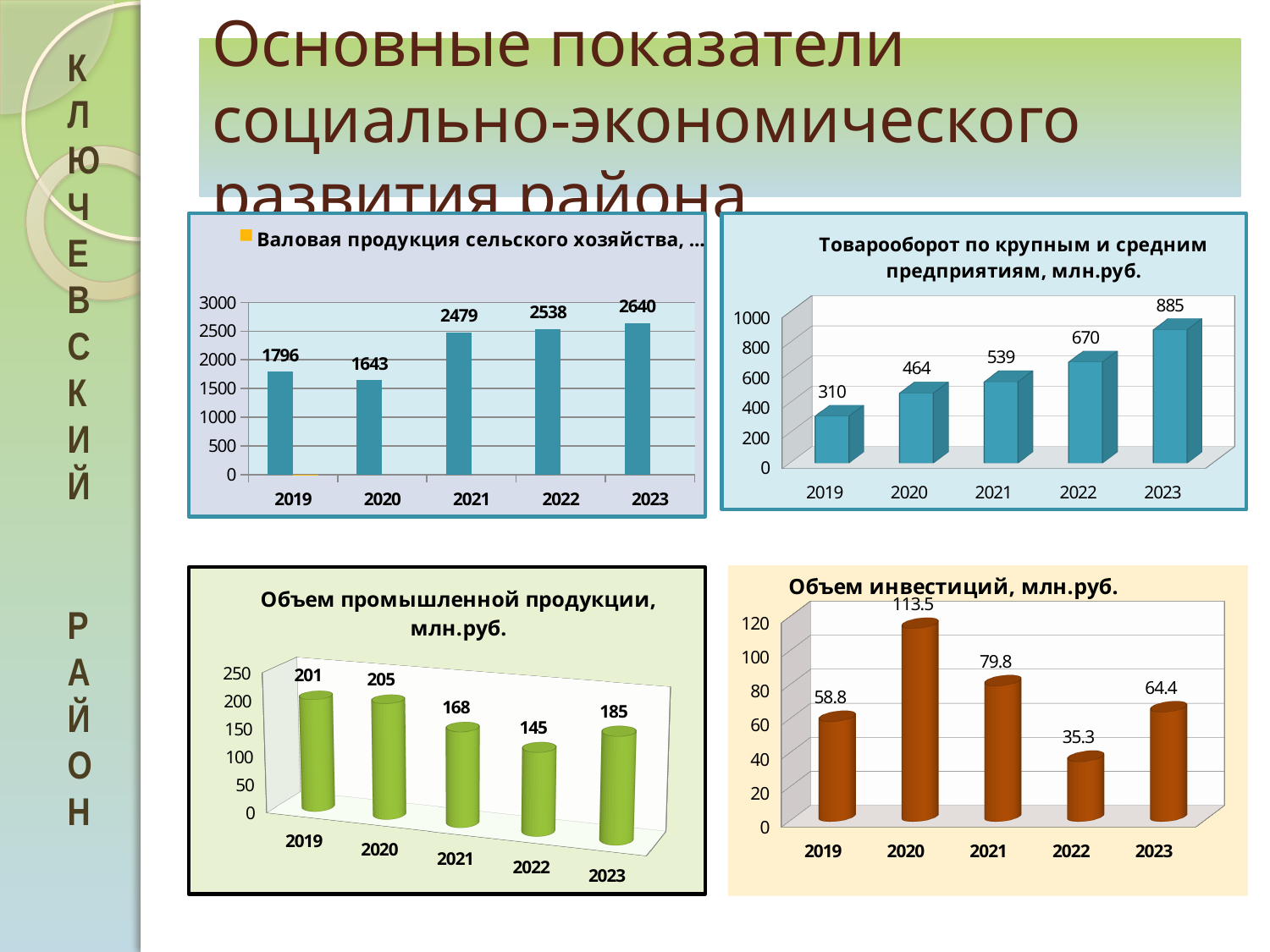
In the bottom-right chart (Объем инвестиций, млн.руб.), what is the value for 2020? 113.5 In the top-right chart (Товарооборот по крупным и средним предприятиям, млн.руб.), what is the difference between the 2023 and 2019 values? 575 In the bottom-right chart (Объем инвестиций, млн.руб.), which is larger, the value for 2021 or the value for 2023? 2021 In the top-left chart (Валовая продукция сельского хозяйства), which year has the lowest value? 2020 In the bottom-left chart (Объем промышленной продукции, млн.руб.), which year has the highest value? 2020 In the top-right chart (Товарооборот по крупным и средним предприятиям, млн.руб.), what is the value for 2023? 885 What kind of chart is the bottom-right chart (Объем инвестиций, млн.руб.)? bar chart In the bottom-left chart (Объем промышленной продукции, млн.руб.), how many years are shown on the x axis? 5 In the top-left chart (Валовая продукция сельского хозяйства), is the value for 2022 greater or less than 2500? greater In the top-left chart (Валовая продукция сельского хозяйства), what is the value for 2021? 2479 In the top-right chart (Товарооборот по крупным и средним предприятиям, млн.руб.), which year has the lowest value? 2019 In the bottom-left chart (Объем промышленной продукции, млн.руб.), what is the value for 2022? 145